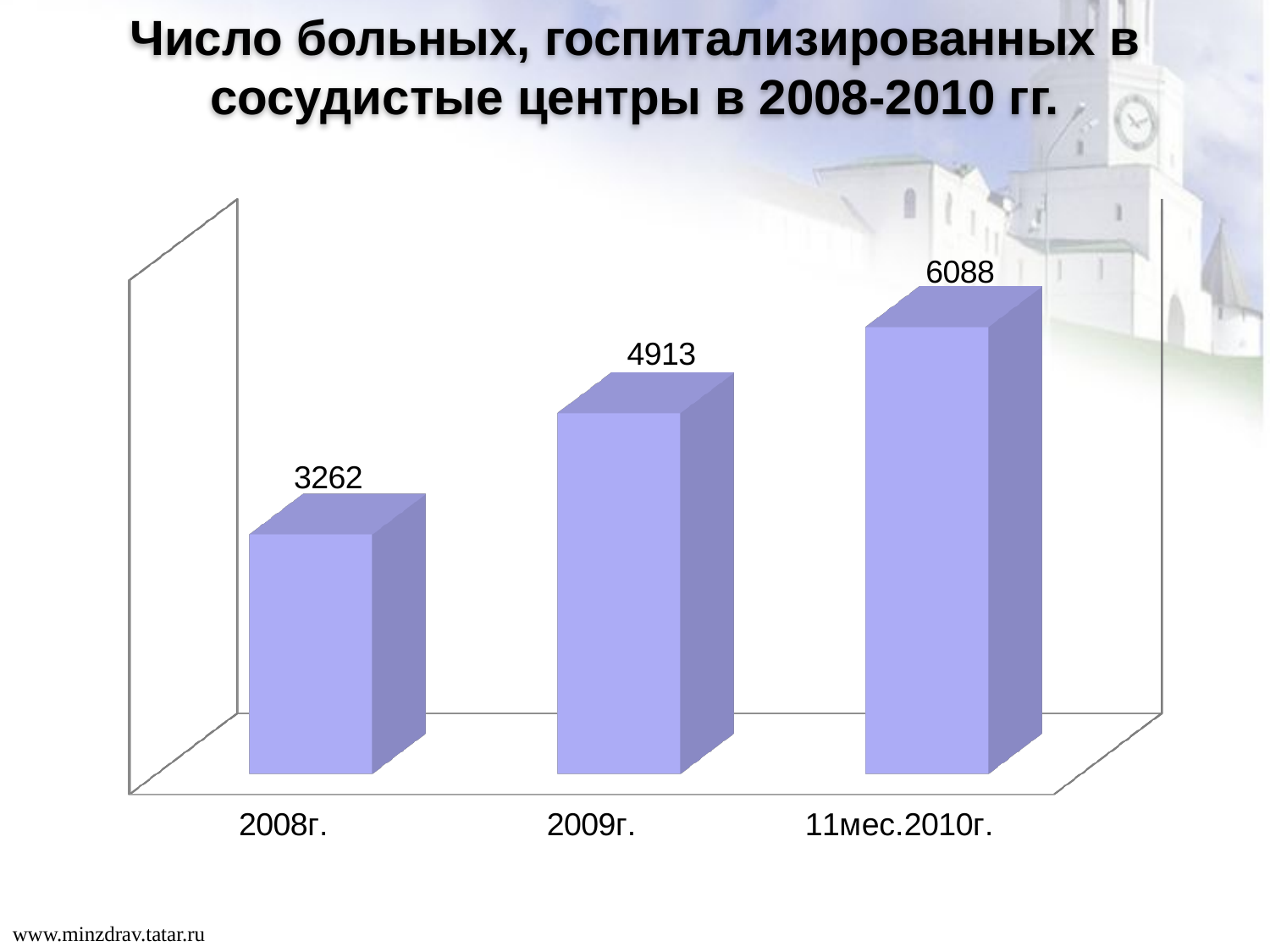
What is the number of patients hospitalized in vascular centers in 2008г.? 3262 What is the difference between the values for 2009г. and 2008г.? 1651 How many categories are shown on the x axis? 3 What is the difference between the values for 11мес.2010г. and 2009г.? 1175 Do the values rise or fall from 2008г. to 11мес.2010г.? rise What is the title of the chart? Число больных, госпитализированных в сосудистые центры в 2008-2010 гг. Which is larger, the value for 2009г. or the value for 2008г.? 2009г. Which category has the lowest value? 2008г. What is the value shown for 2009г.? 4913 Which category has the highest value? 11мес.2010г. What kind of chart is shown on the slide? bar chart What is the value shown for 11мес.2010г.? 6088